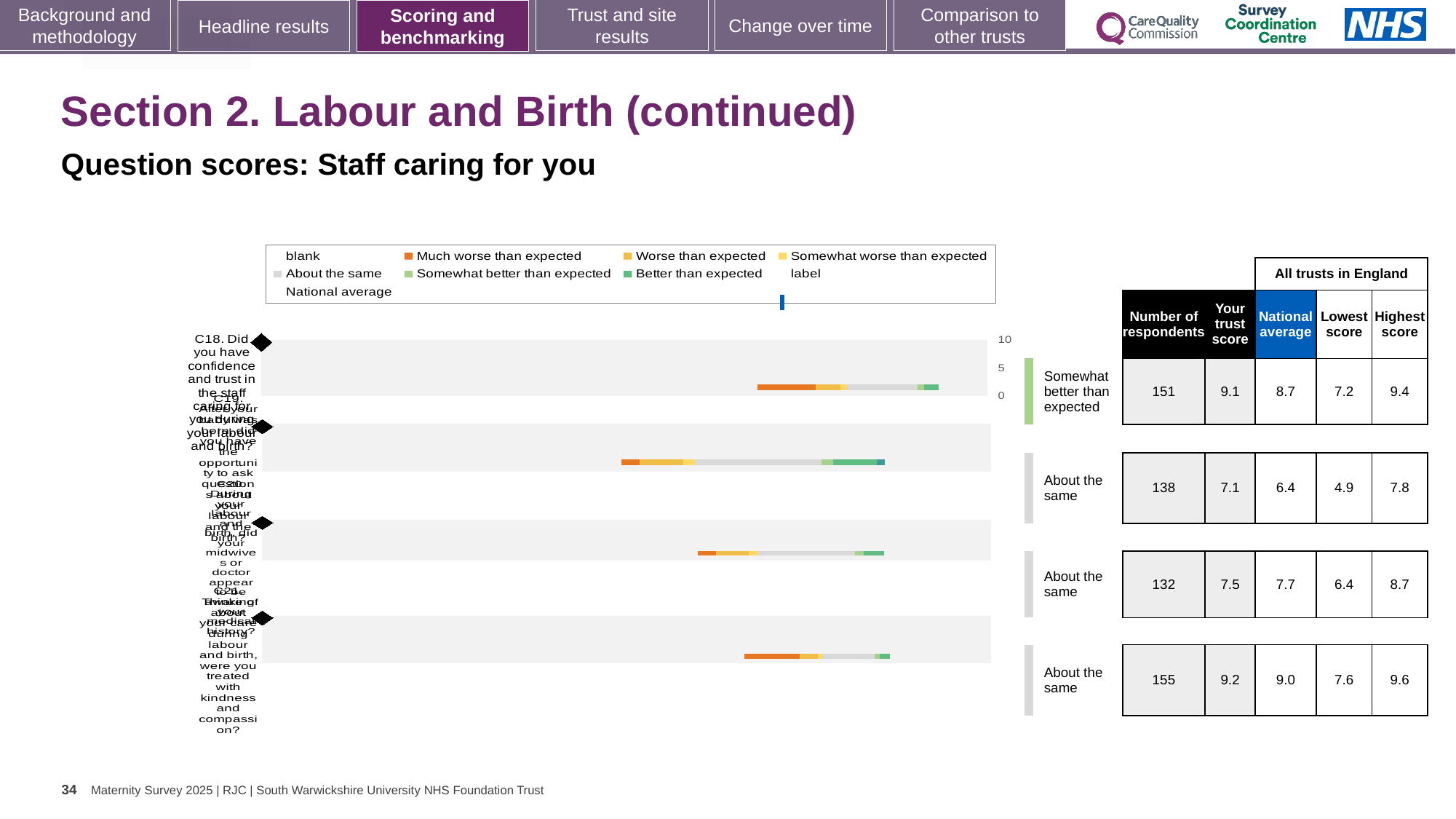
In the table, what is the number of respondents for C18 (the first row)? 151 What is the difference between the trust score and the national average in the first row (C18)? 0.4 In the table, what is the lowest score for the row with 138 respondents? 4.9 What kind of chart is shown on the slide? bar chart What benchmark category is shown for the first row (C18)? Somewhat better than expected In the table, what is the national average for the first row (C18)? 8.7 In the third row of the table, which is larger: the trust score or the national average? the national average (7.7) In the table, what is the highest score for the last row (C21)? 9.6 Which row of the table has the highest number of respondents? the last row (155) In the table, what is the trust score for C18 (the first row)? 9.1 How many question bars are plotted in the chart? 4 Which row of the table has the lowest trust score? the second row (7.1)